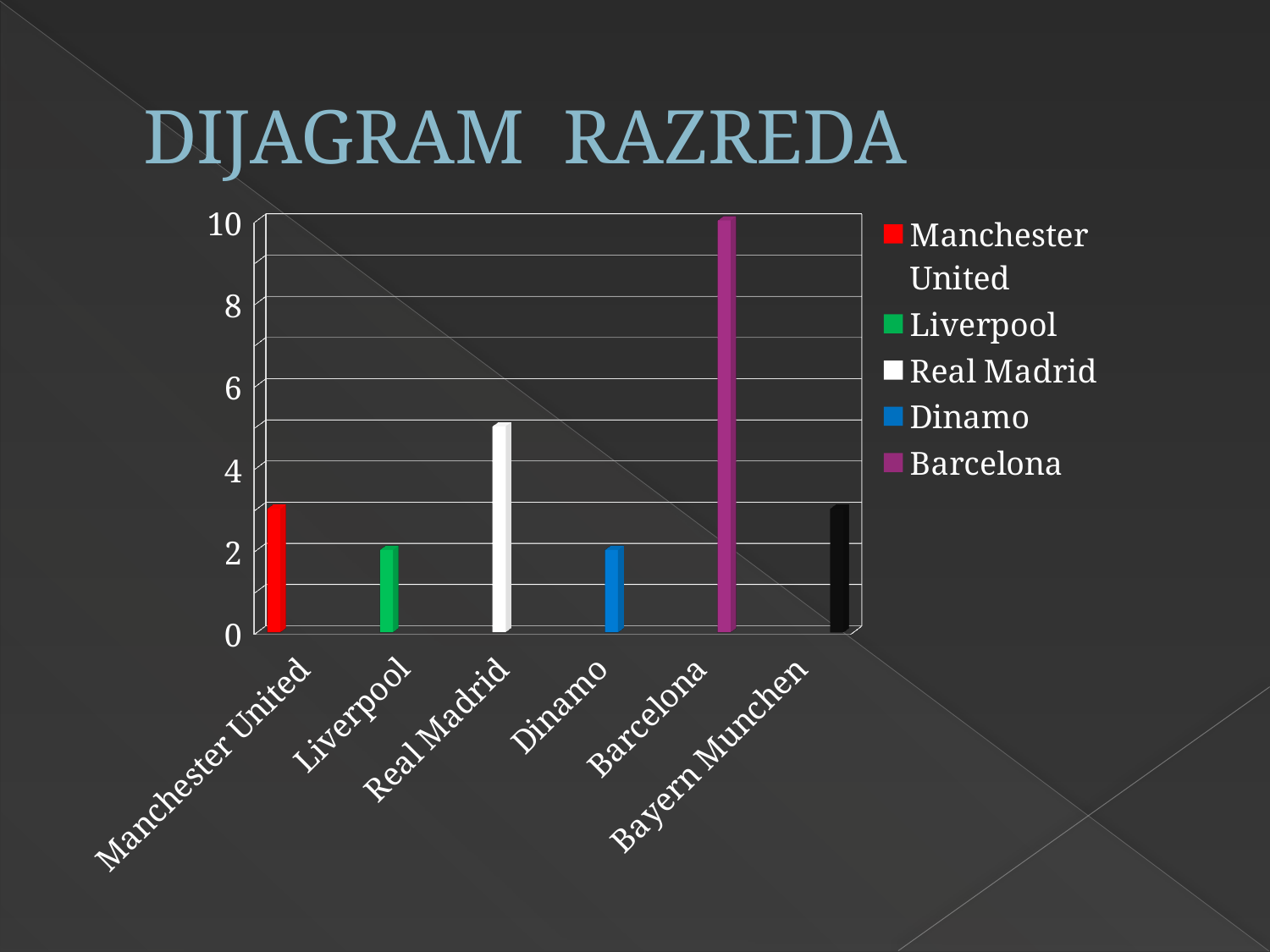
What is the value for Liverpool? 2 What type of chart is shown on the slide? Bar chart What is the difference between the values for Barcelona and Liverpool? 8 Is the value for Real Madrid greater or less than 4? greater Which is larger, the value for Real Madrid or the value for Manchester United? Real Madrid What is the value for Dinamo? 2 Is the value for Manchester United greater or less than 2? greater How many categories are shown on the x axis? 6 Is the value for Bayern Munchen greater or less than 4? less How many entries does the legend list? 5 What is the value for Barcelona? 10 Which category has the highest value? Barcelona